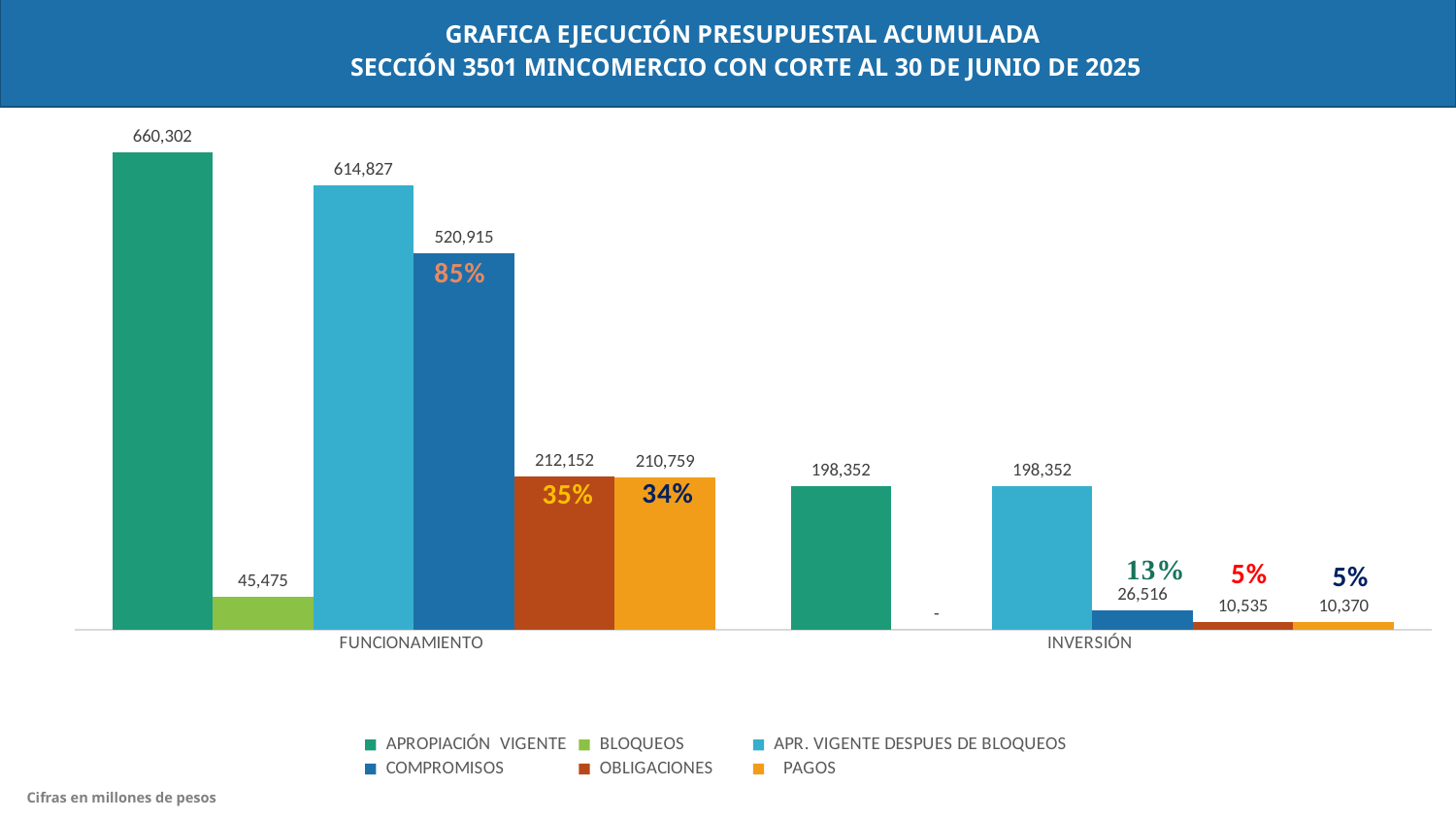
What kind of chart is shown on the slide? Bar chart Which series has the lowest value for INVERSIÓN (excluding the dash for BLOQUEOS)? PAGOS What is the value of COMPROMISOS for INVERSIÓN? 26,516 Which is larger: OBLIGACIONES for FUNCIONAMIENTO or COMPROMISOS for INVERSIÓN? OBLIGACIONES for FUNCIONAMIENTO What is the difference between APROPIACIÓN VIGENTE and APR. VIGENTE DESPUES DE BLOQUEOS for FUNCIONAMIENTO? 45,475 What percentage is shown on the COMPROMISOS bar for FUNCIONAMIENTO? 85% Which series has the highest value for FUNCIONAMIENTO? APROPIACIÓN VIGENTE What is the value of BLOQUEOS for FUNCIONAMIENTO? 45,475 What is the value of PAGOS for FUNCIONAMIENTO? 210,759 How many categories are shown on the x axis? 2 What is the value of APROPIACIÓN VIGENTE for FUNCIONAMIENTO? 660,302 How many series does the legend list? 6